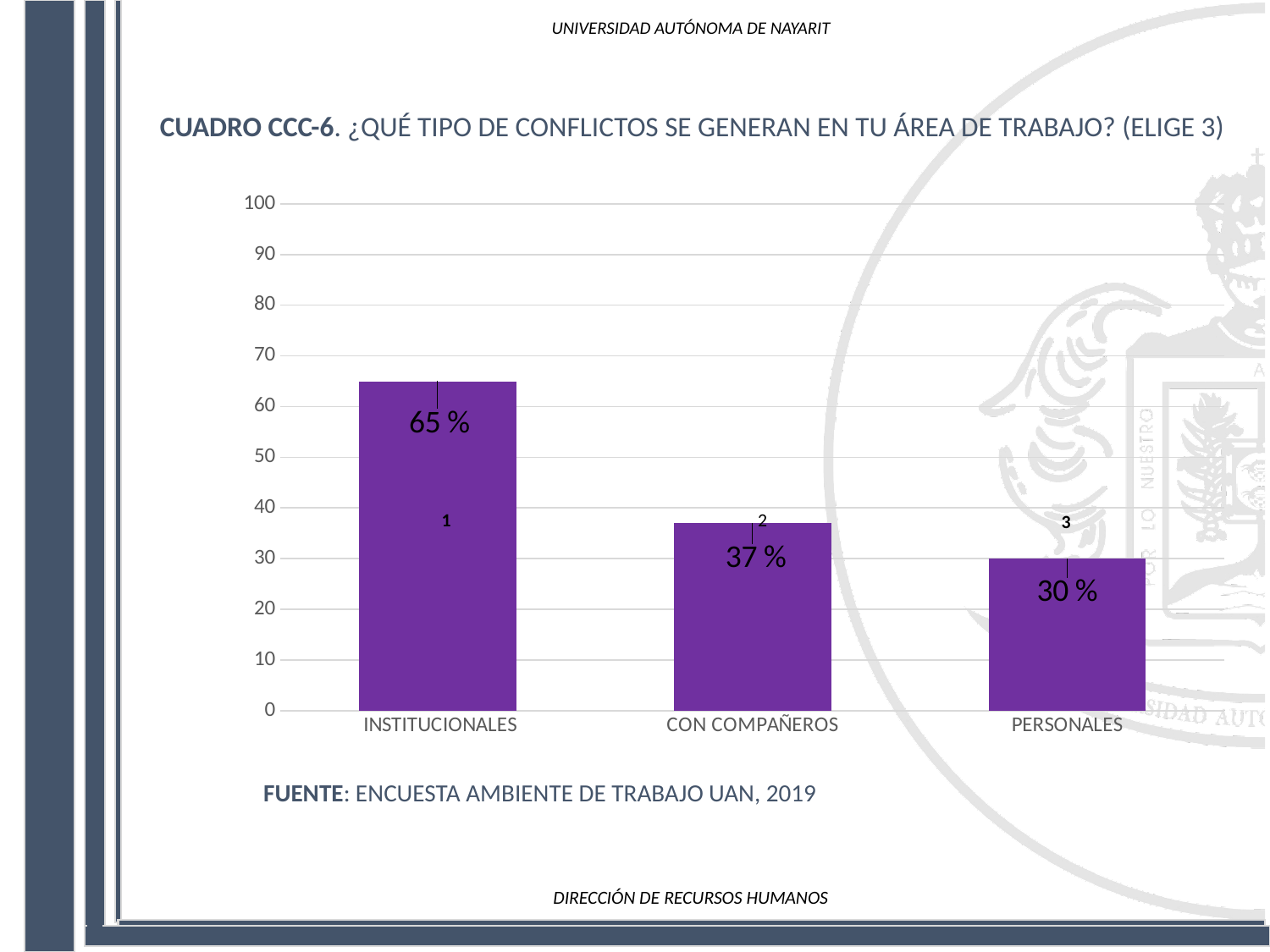
What is the value for CON COMPAÑEROS? 37 % Which category has the lowest value? PERSONALES What is the value for INSTITUCIONALES? 65 % What kind of chart is shown on the slide? bar chart What is the difference between the values for INSTITUCIONALES and CON COMPAÑEROS? 28 % What is the value for PERSONALES? 30 % How many categories are shown on the x axis? 3 Which is larger, the value for CON COMPAÑEROS or the value for PERSONALES? CON COMPAÑEROS Which category has the highest value? INSTITUCIONALES Is the value for INSTITUCIONALES greater or less than 60? greater What source is cited below the chart? ENCUESTA AMBIENTE DE TRABAJO UAN, 2019 What is the difference between the values for CON COMPAÑEROS and PERSONALES? 7 %